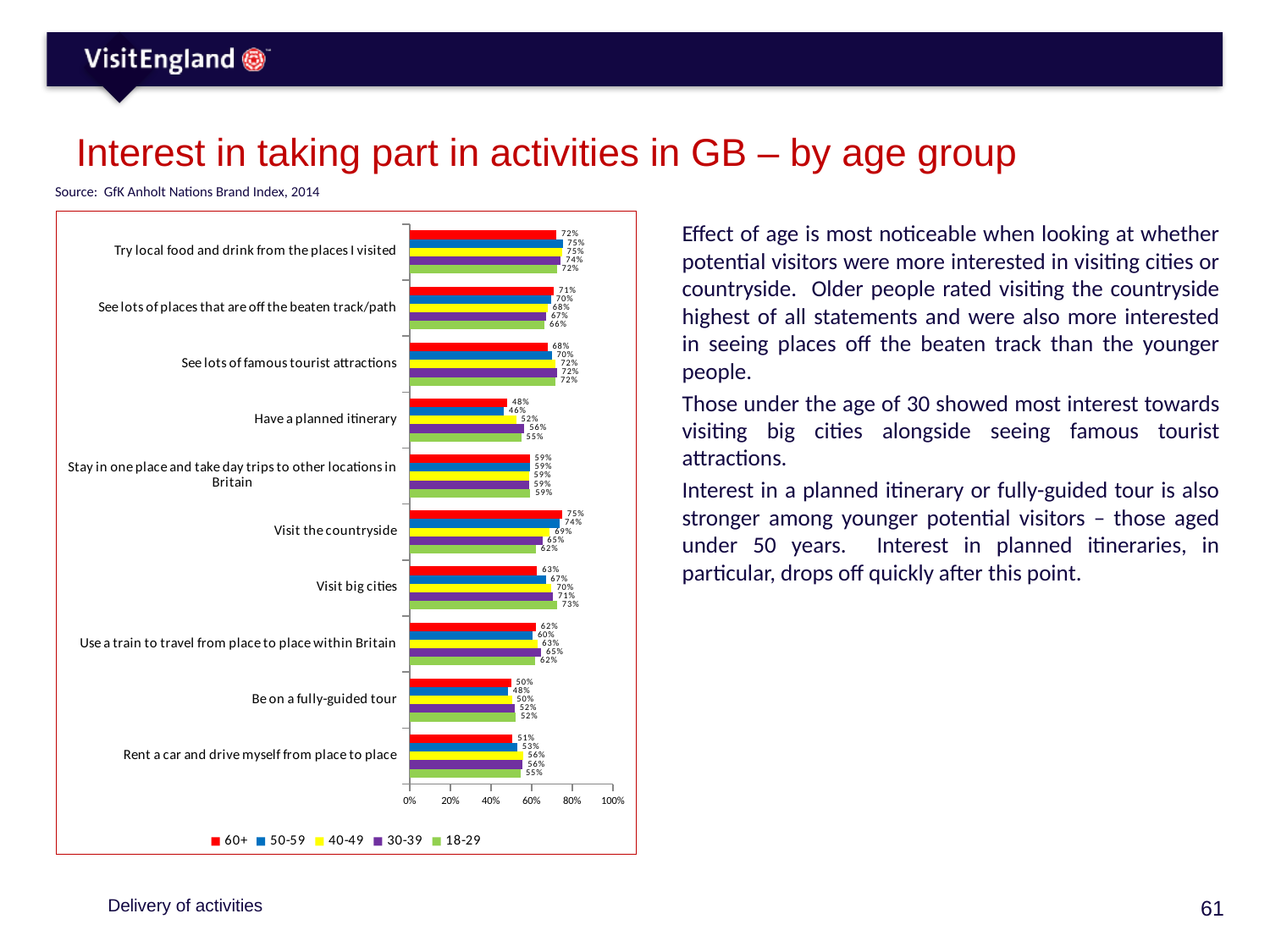
What is the value for the 50-59 age group for 'Have a planned itinerary'? 46% How many activity categories are plotted in the chart? 10 Which age group has the lowest value for 'Visit the countryside'? 18-29 What is the value for the 18-29 age group for 'Visit big cities'? 73% Which age group has the highest value for 'Visit big cities'? 18-29 What type of chart is shown on the slide? bar chart What is the difference between the 60+ and 18-29 values for 'Visit the countryside'? 13% What is the value for the 60+ age group for 'Visit the countryside'? 75% Which is larger for 'Have a planned itinerary': the value for 30-39 or the value for 60+? 30-39 Which colour represents the 40-49 age group in the legend? yellow How many age-group series does the legend list? 5 Do the values for 'Visit big cities' rise or fall moving from the 60+ group to the 18-29 group? rise